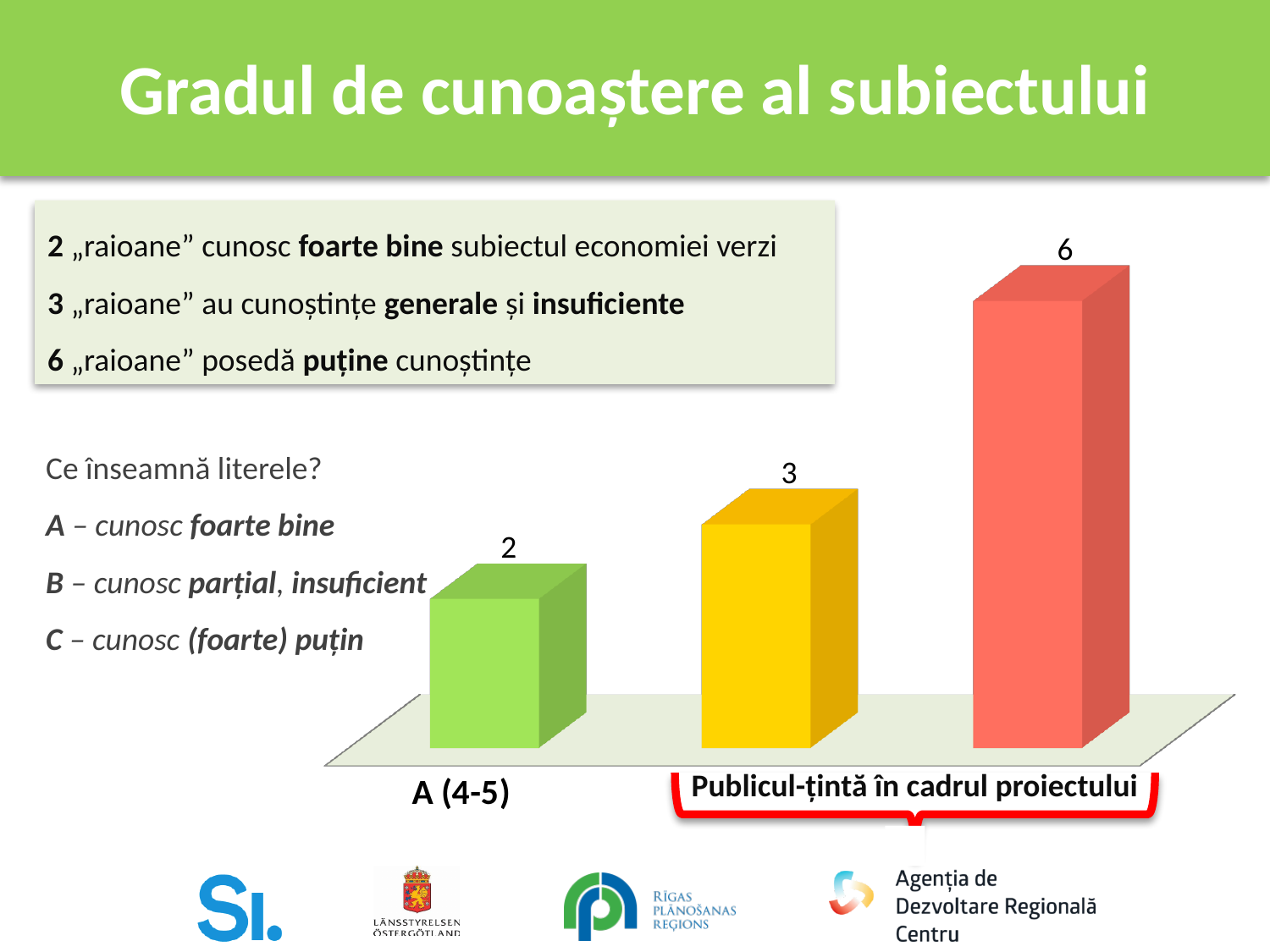
Do the bar values rise or fall from left to right? Rise What is the value of the bar labelled A (4-5)? 2 What colour is the bar labelled A (4-5)? Green What is the value of the yellow (middle) bar? 3 What kind of chart is shown on the slide? Bar chart Which is larger, the bar labelled A (4-5) or the yellow (middle) bar? The yellow (middle) bar Which bar has the highest value? The red (rightmost) bar, 6 How many bars are shown in the chart? 3 What is the difference between the yellow (middle) bar and the bar labelled A (4-5)? 1 What is the value of the red (rightmost) bar? 6 Which bar has the lowest value? A (4-5) What is the difference between the red (rightmost) bar and the bar labelled A (4-5)? 4